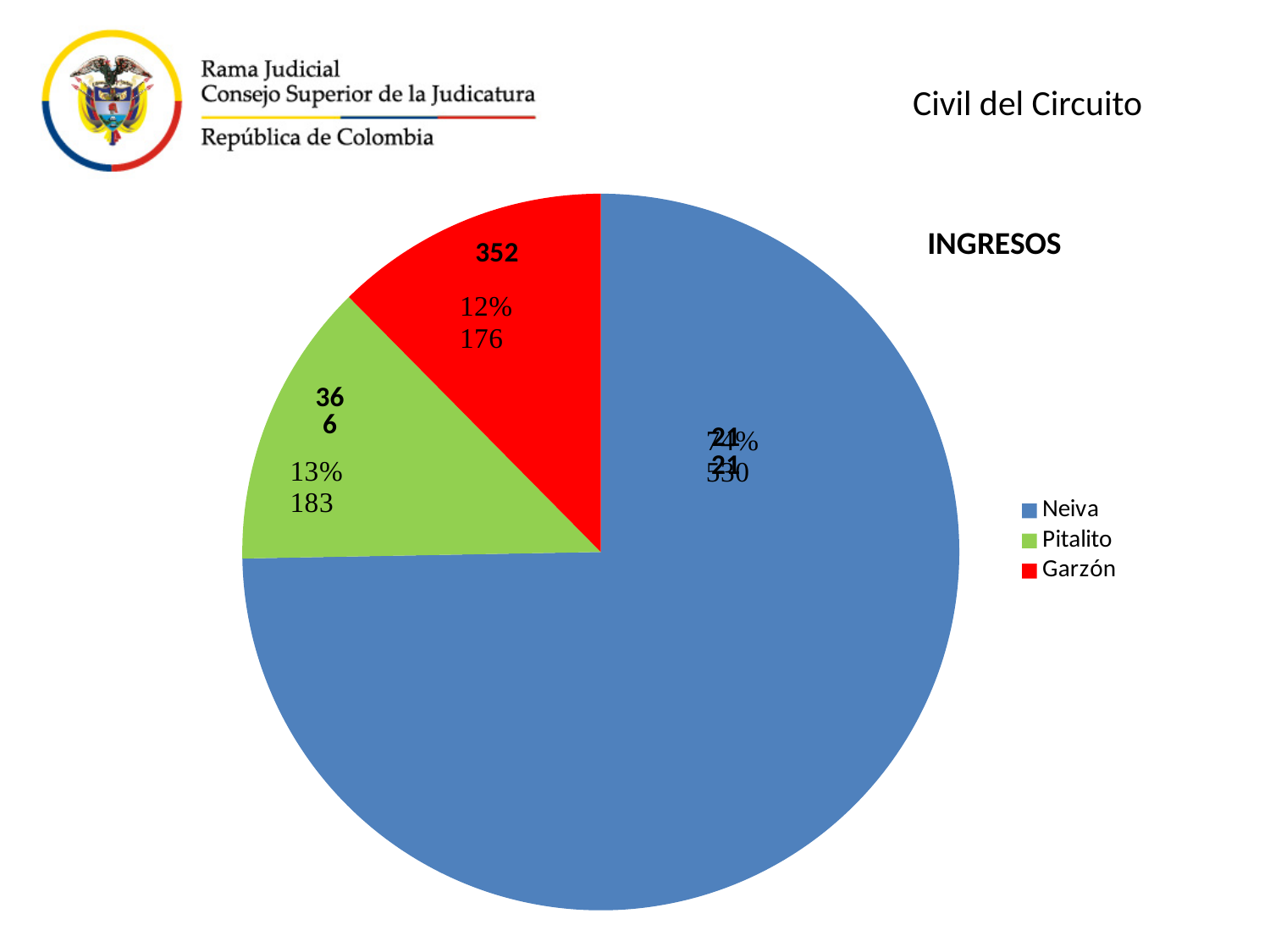
Which slice is larger, Neiva or Pitalito? Neiva Which category has the smallest slice of the pie? Garzón What percentage share of the pie does Garzón have? 12% Which colour represents Garzón in the pie chart? red Which slice is larger, Pitalito or Garzón? Pitalito What percentage share of the pie does Pitalito have? 13% What kind of chart is shown on the slide? pie chart How many slices does the pie chart have? 3 How many entries does the legend list? 3 Which category has the largest slice of the pie? Neiva What is the title of the chart? INGRESOS